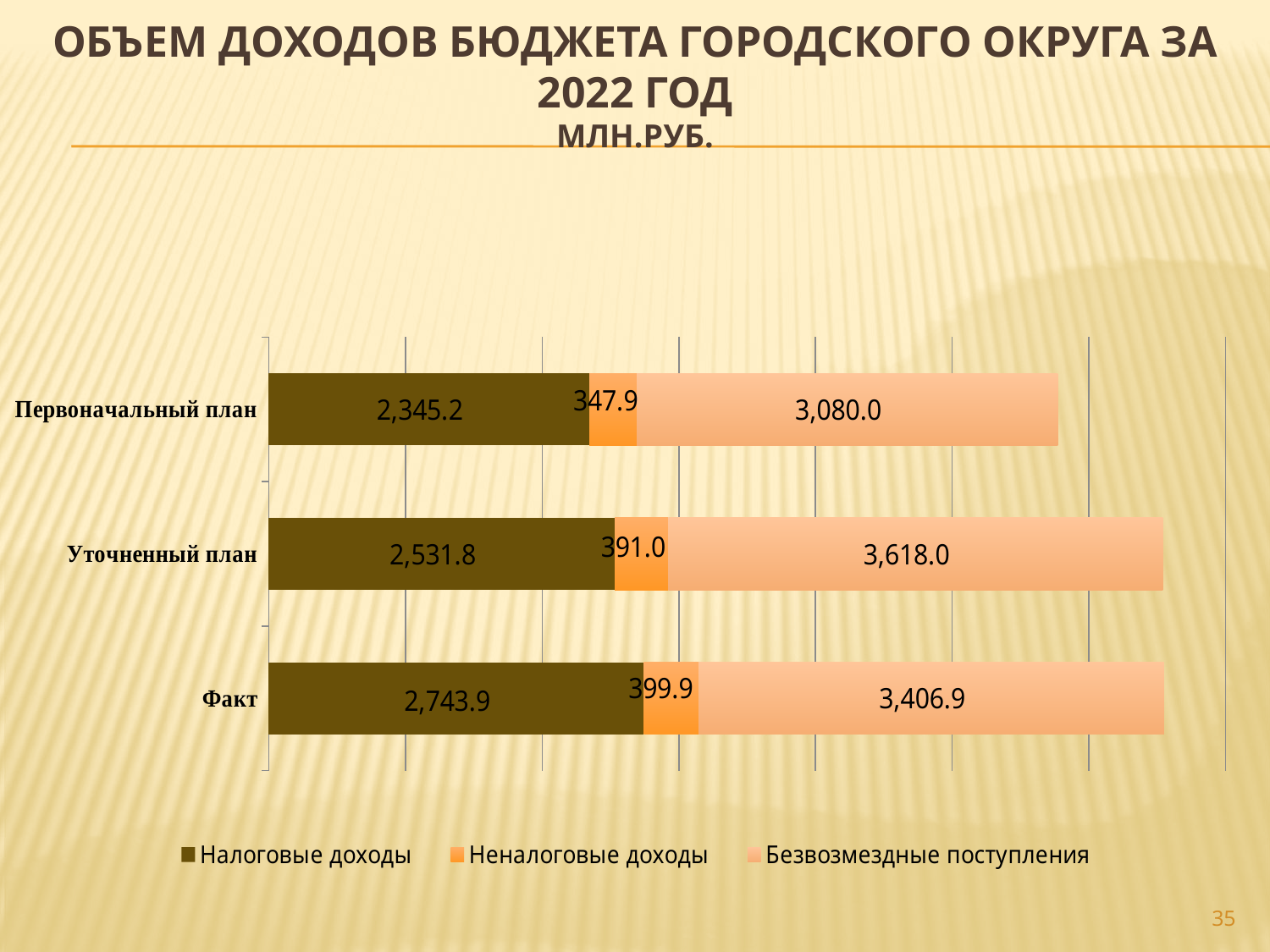
Which category has the lowest value of Безвозмездные поступления? Первоначальный план Which series is shown in the darkest (dark brown) colour? Налоговые доходы How many series does the legend list? 3 What is the difference between Налоговые доходы for Факт and for Первоначальный план? 398.7 What is the value of Неналоговые доходы for Первоначальный план? 347.9 Which category has the highest value of Налоговые доходы? Факт What type of chart is shown on the slide? Stacked bar chart What is the value of Налоговые доходы for Факт? 2,743.9 What is the value of Безвозмездные поступления for Уточненный план? 3,618.0 What is the total of the stacked bar for Первоначальный план? 5,773.1 Which is larger: Безвозмездные поступления for Уточненный план or for Факт? Уточненный план How many categories (bars) are shown in the chart? 3